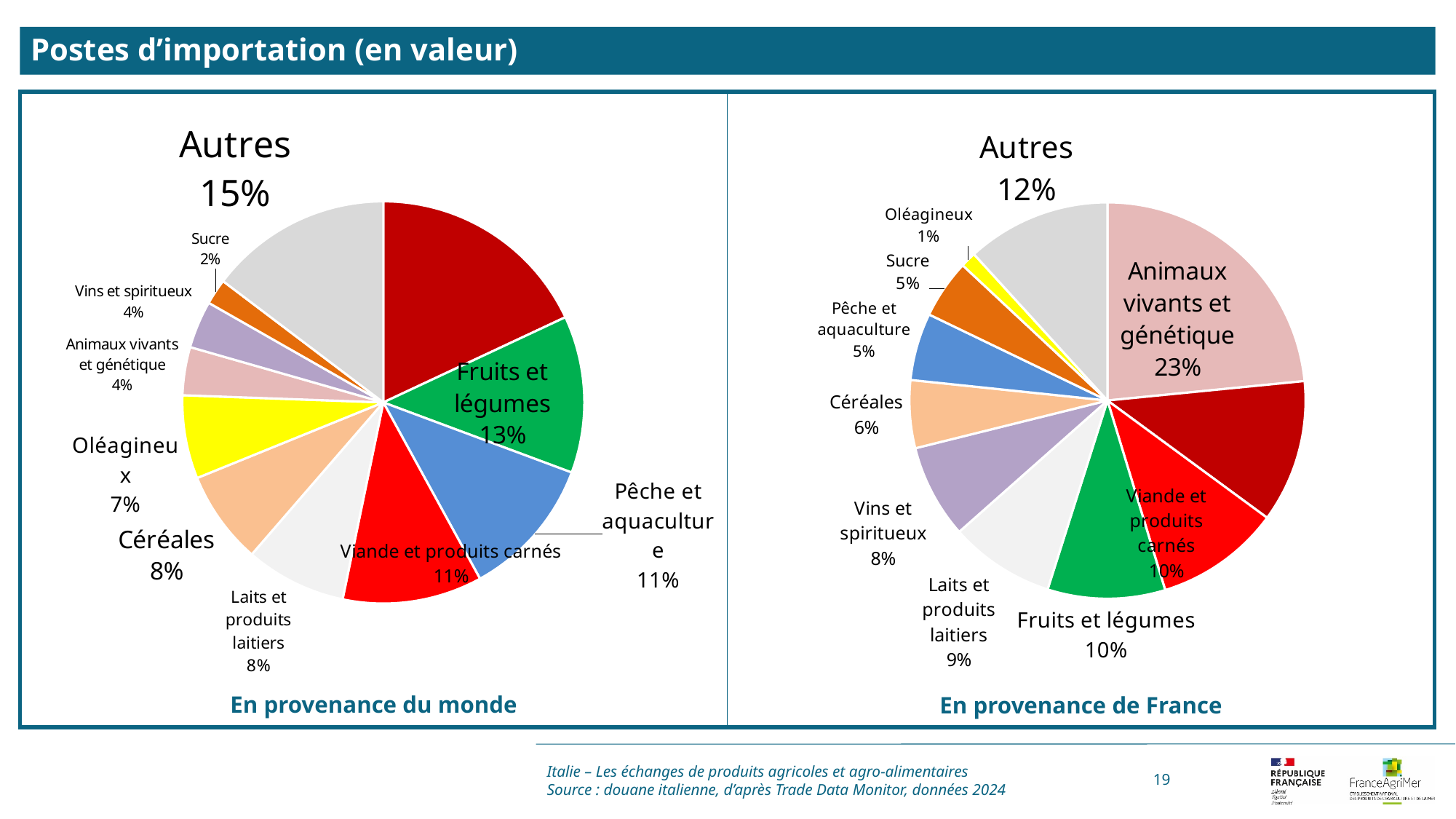
In the 'En provenance du monde' pie chart, which is larger: Pêche et aquaculture or Vins et spiritueux? Pêche et aquaculture In the 'En provenance de France' pie chart, what is the difference between the shares of Animaux vivants et génétique and Autres? 11% What type of chart is used on this slide? Pie chart In the 'En provenance du monde' pie chart, what share is labelled for Oléagineux? 7% What is the title of the slide? Postes d'importation (en valeur) In the 'En provenance du monde' pie chart, which labelled category has the smallest share? Sucre In the 'En provenance de France' pie chart, what share is labelled for Animaux vivants et génétique? 23% In the 'En provenance de France' pie chart, which category has the largest share? Animaux vivants et génétique In the 'En provenance du monde' pie chart, what is the difference between the shares of Fruits et légumes and Céréales? 5% In the 'En provenance de France' pie chart, which category has the smallest share? Oléagineux In the 'En provenance de France' pie chart, which is larger: Laits et produits laitiers or Céréales? Laits et produits laitiers In the 'En provenance du monde' pie chart, what share is labelled for Fruits et légumes? 13%